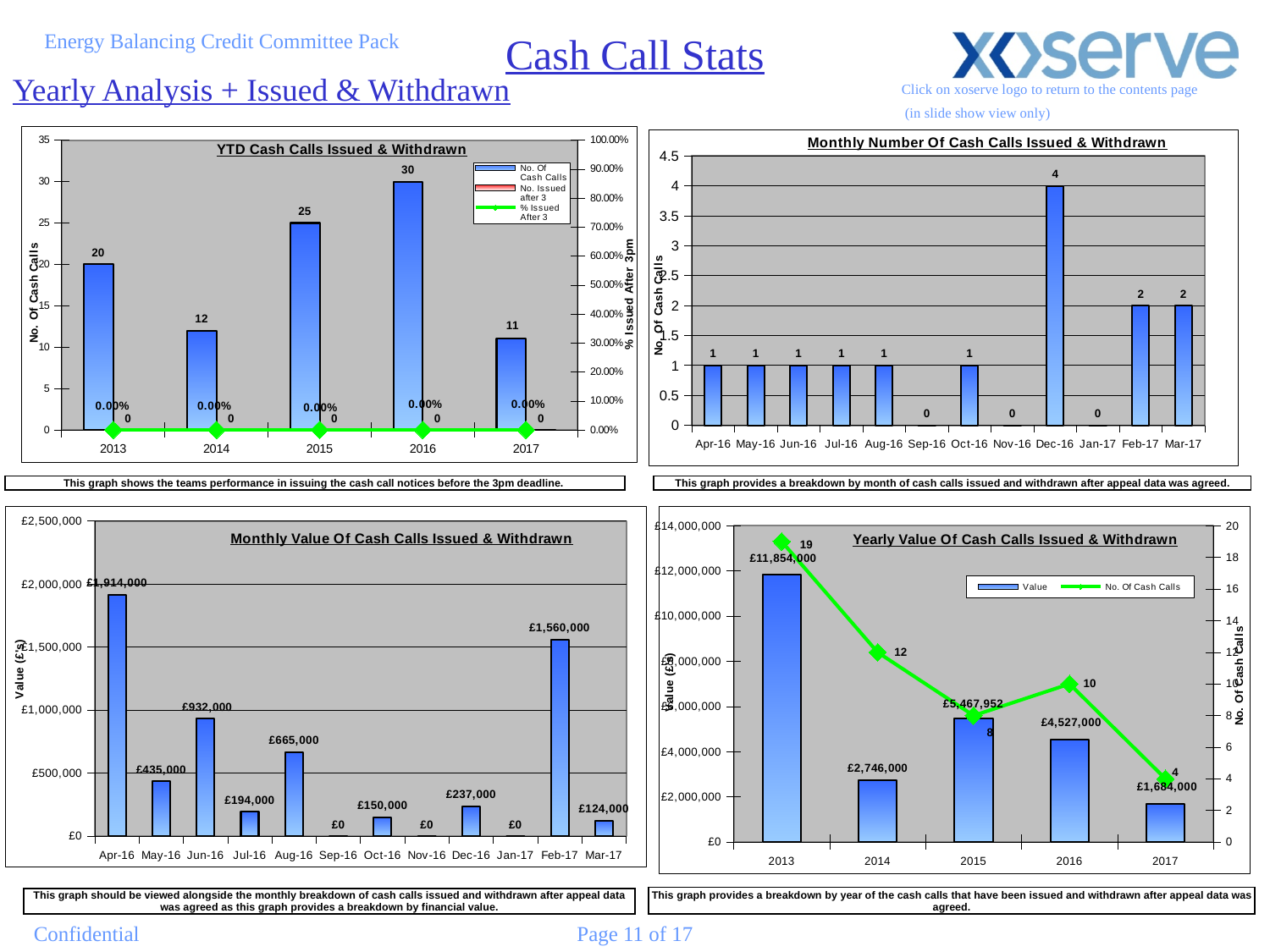
In the 'Monthly Number Of Cash Calls Issued & Withdrawn' chart, which month has the highest number of cash calls? Dec-16 In the 'Monthly Number Of Cash Calls Issued & Withdrawn' chart, what is the value for Feb-17? 2 In the 'Yearly Value Of Cash Calls Issued & Withdrawn' chart, how many cash calls were there in 2013 according to the line series? 19 In the 'Monthly Value Of Cash Calls Issued & Withdrawn' chart, which is larger, the value for Apr-16 or Feb-17? Apr-16 In the 'Yearly Value Of Cash Calls Issued & Withdrawn' chart, what is the value for 2015? £5,467,952 In the 'YTD Cash Calls Issued & Withdrawn' chart, how many series does the legend list? 3 In the 'YTD Cash Calls Issued & Withdrawn' chart, what is the difference in the number of cash calls between 2015 and 2014? 13 In the 'Monthly Value Of Cash Calls Issued & Withdrawn' chart, what is the value for Jun-16? £932,000 In the 'YTD Cash Calls Issued & Withdrawn' chart, how many cash calls were there in 2016? 30 In the 'Monthly Number Of Cash Calls Issued & Withdrawn' chart, how many months are shown on the x axis? 12 In the 'YTD Cash Calls Issued & Withdrawn' chart, which year has the lowest number of cash calls? 2017 In the 'Monthly Value Of Cash Calls Issued & Withdrawn' chart, what kind of chart is used? Bar chart